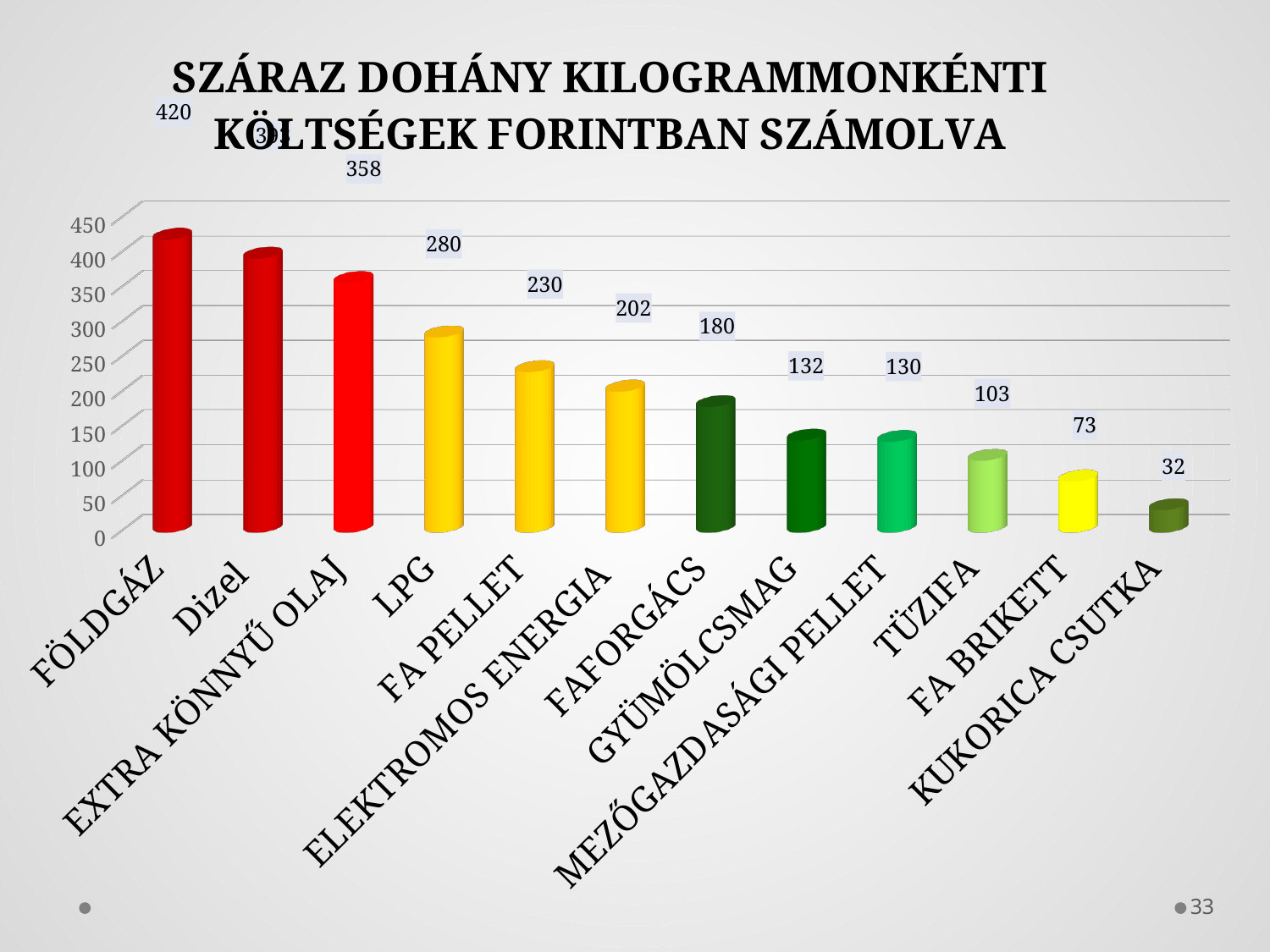
Do the values rise or fall from left to right along the x axis? fall What is the value for FÖLDGÁZ? 420 Which is larger, the value for FA PELLET or the value for FAFORGÁCS? FA PELLET Which category has the highest value? FÖLDGÁZ Is the value for Dizel greater or less than 350? greater What type of chart is shown on the slide? bar chart What is the value for KUKORICA CSUTKA? 32 What is the value for LPG? 280 How many categories are plotted in the chart? 12 Which category has the lowest value? KUKORICA CSUTKA What is the difference between the values for FÖLDGÁZ and EXTRA KÖNNYŰ OLAJ? 62 What is the value for TÜZIFA? 103